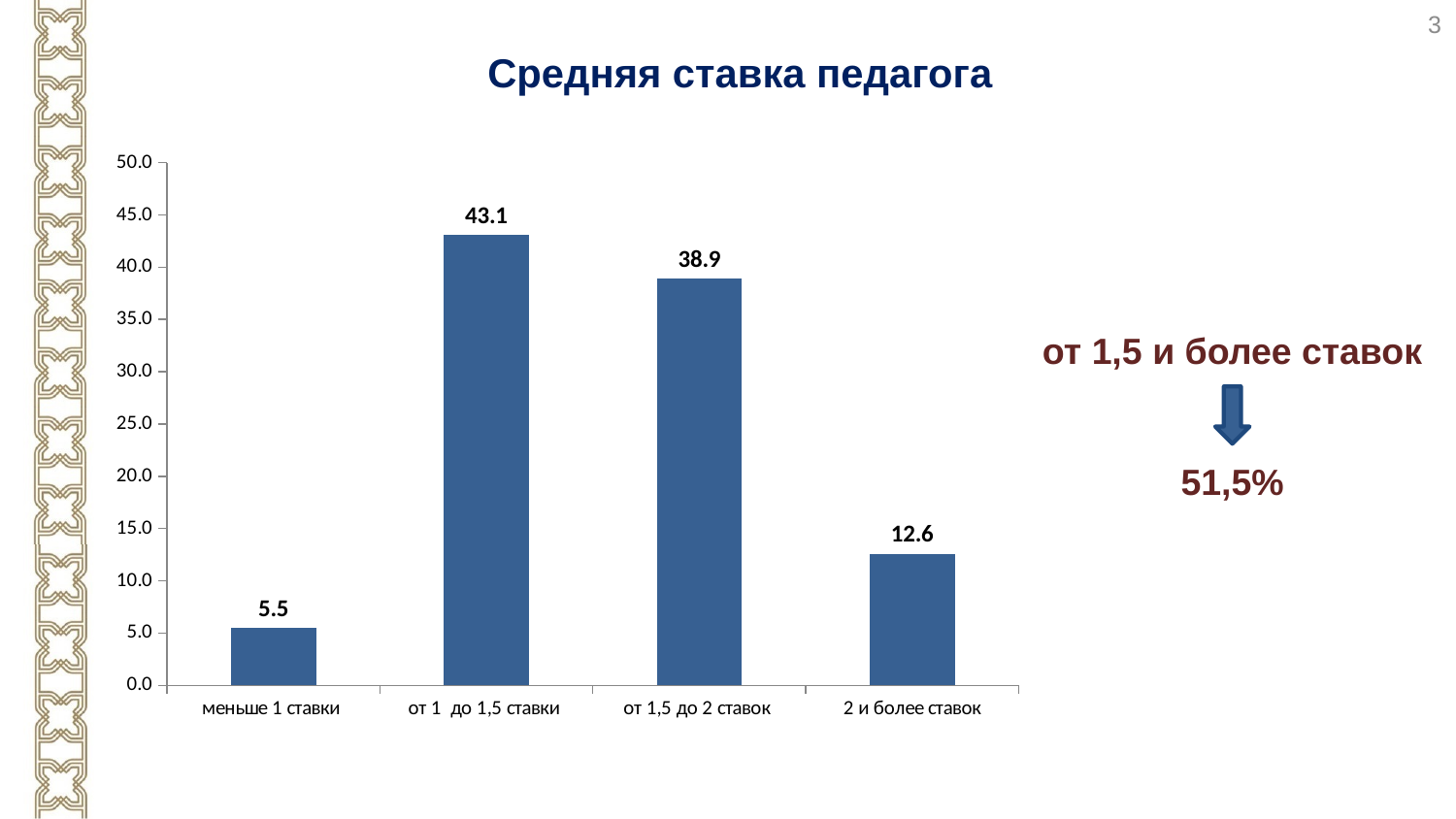
What is the difference between the values for "от 1 до 1,5 ставки" and "от 1,5 до 2 ставок"? 4.2 What is the title of the chart? Средняя ставка педагога Which category has the highest value? от 1 до 1,5 ставки How many categories are shown on the x axis? 4 What is the value for the category "от 1 до 1,5 ставки"? 43.1 What is the maximum value shown on the y axis? 50.0 Which is larger: the value for "2 и более ставок" or the value for "меньше 1 ставки"? 2 и более ставок Which category has the lowest value? меньше 1 ставки What is the value for the category "меньше 1 ставки"? 5.5 Is the value for "от 1,5 до 2 ставок" greater or less than 35.0? greater What is the value for the category "2 и более ставок"? 12.6 What kind of chart is shown on the slide? bar chart